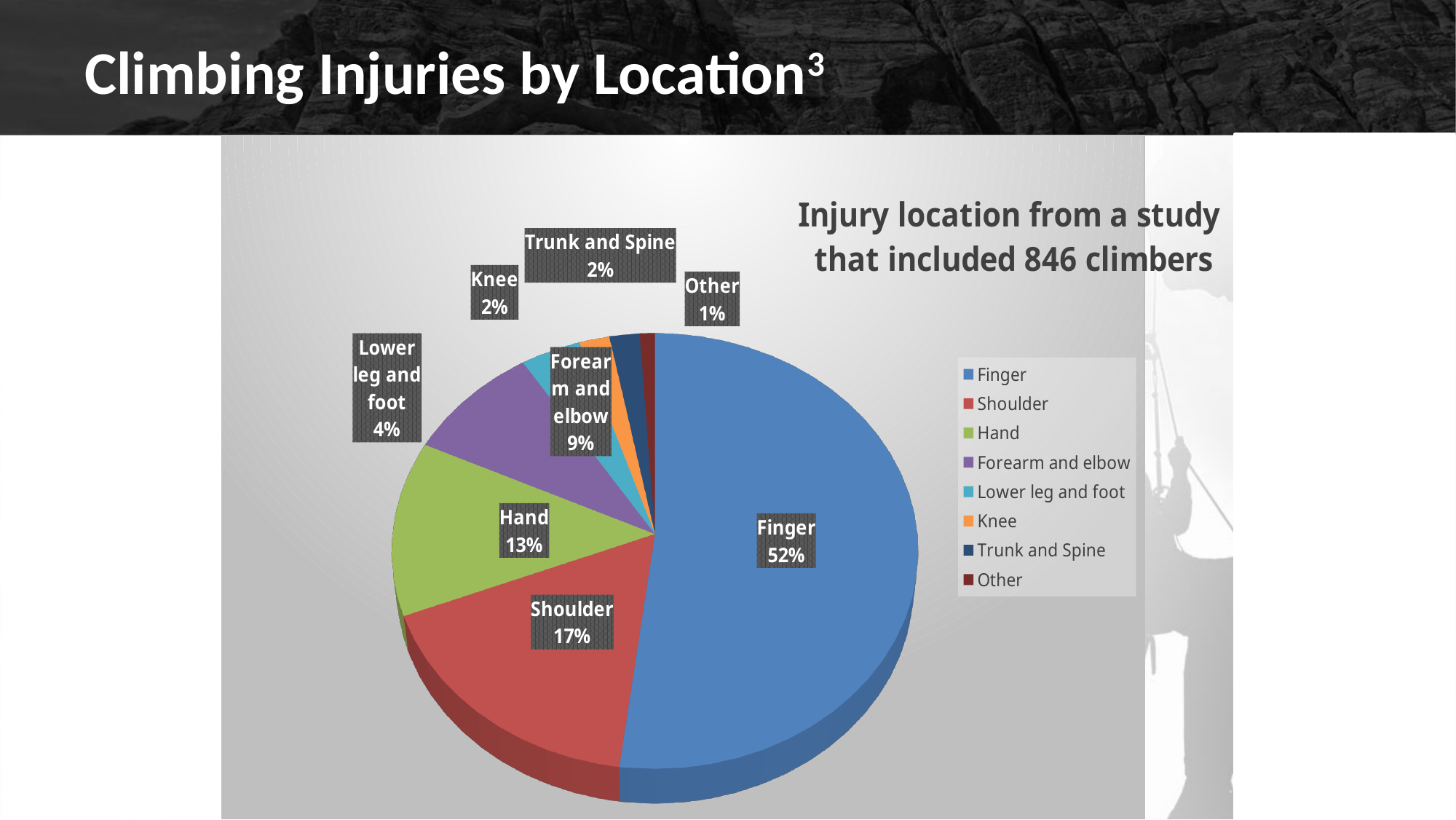
How many injury locations are listed in the legend? 8 What percentage of climbing injuries are finger injuries? 52% What is the value shown for Forearm and elbow? 9% What percentage is shown for Lower leg and foot? 4% What percentage of injuries are hand injuries? 13% How many climbers were included in the study referenced on the slide? 846 What share of injuries is attributed to the shoulder? 17% What is the difference in percentage points between Finger and Shoulder injuries? 35 What type of chart is shown on the slide? pie chart Which injury location has the largest share of the pie? Finger Which injury location has the smallest share of the pie? Other Which is larger, the share for Hand or the share for Forearm and elbow? Hand